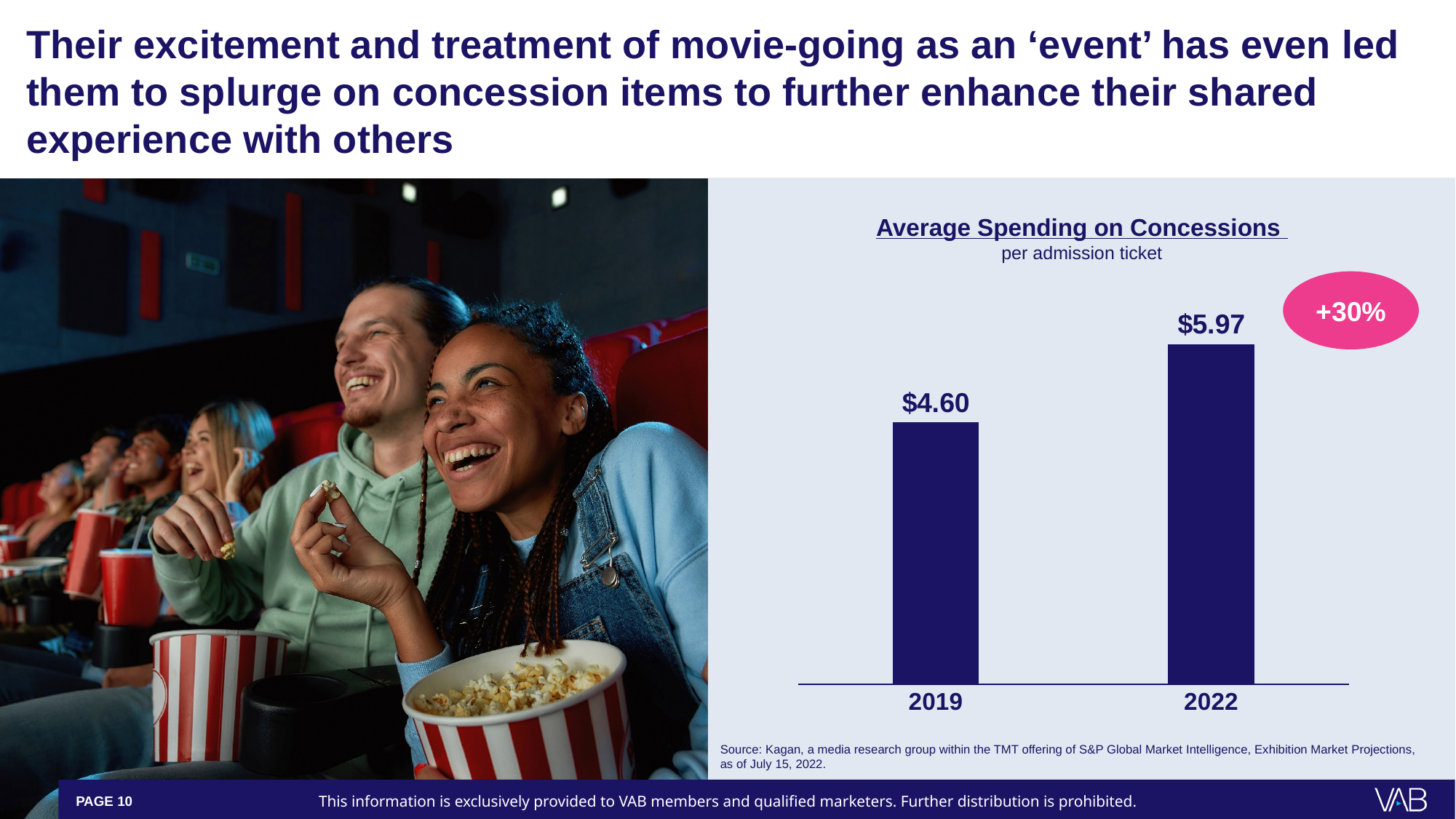
Which year has the higher average spending on concessions? 2022 What percentage change is shown in the pink callout on the chart? +30% What is the title of the chart? Average Spending on Concessions Does average spending on concessions rise or fall from 2019 to 2022? Rise What is the difference in average concession spending between 2022 and 2019? $1.37 What is the average spending on concessions per admission ticket in 2019? $4.60 What kind of chart is used to show average spending on concessions? Bar chart How many years are shown in the chart? 2 Which year has the lower average spending on concessions? 2019 What is the average spending on concessions per admission ticket in 2022? $5.97 Is average concession spending higher in 2019 or 2022? 2022